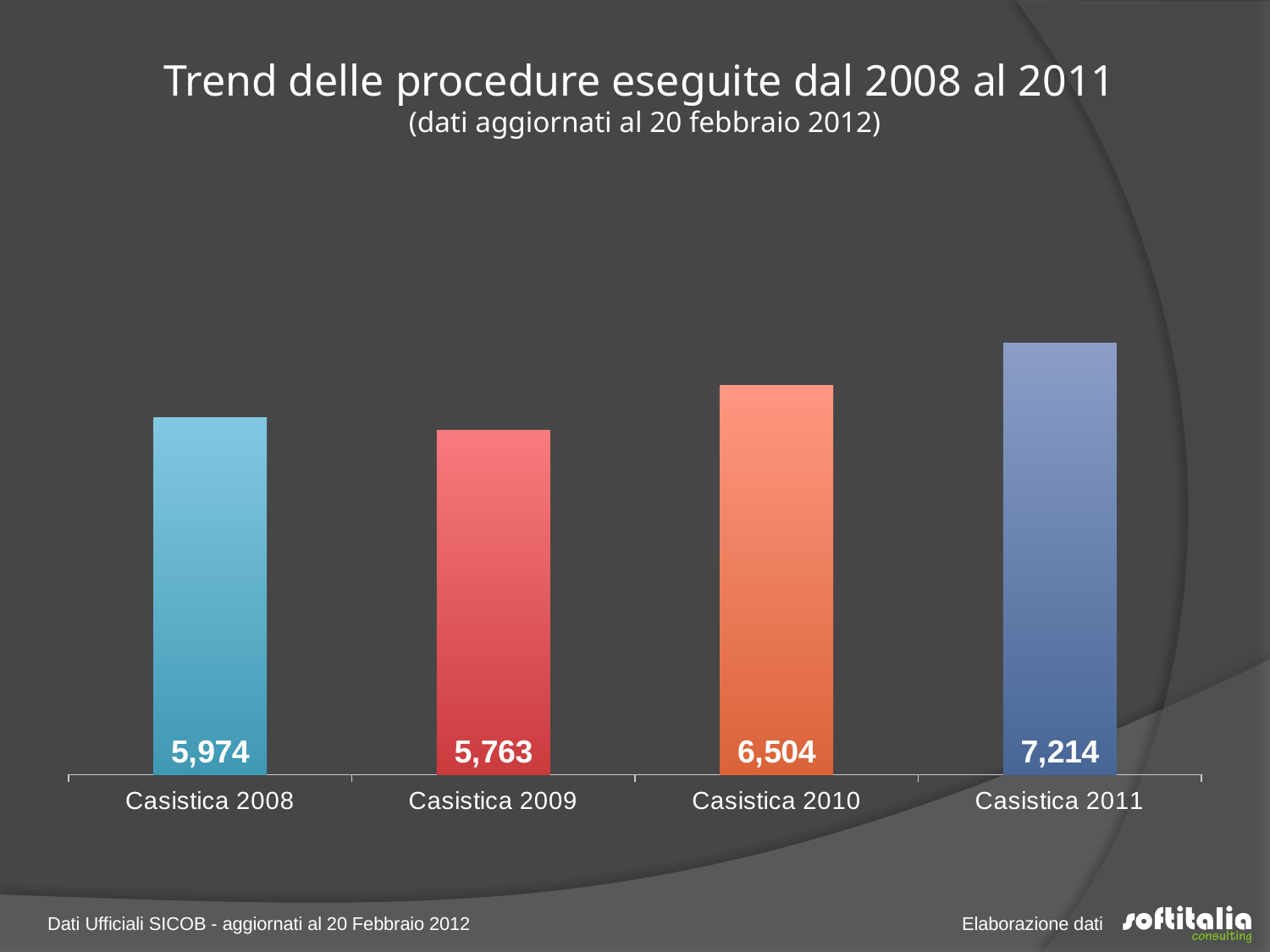
Which is larger, the value for Casistica 2008 or Casistica 2009? Casistica 2008 What is the value for Casistica 2008? 5,974 What is the value for Casistica 2011? 7,214 What kind of chart is shown on the slide? Bar chart What is the difference between the values for Casistica 2010 and Casistica 2009? 741 How many categories are shown in the chart? 4 What is the value for Casistica 2010? 6,504 Which category has the highest value? Casistica 2011 What is the title of the chart? Trend delle procedure eseguite dal 2008 al 2011 What is the difference between the values for Casistica 2011 and Casistica 2008? 1,240 Which category has the lowest value? Casistica 2009 What is the value for Casistica 2009? 5,763